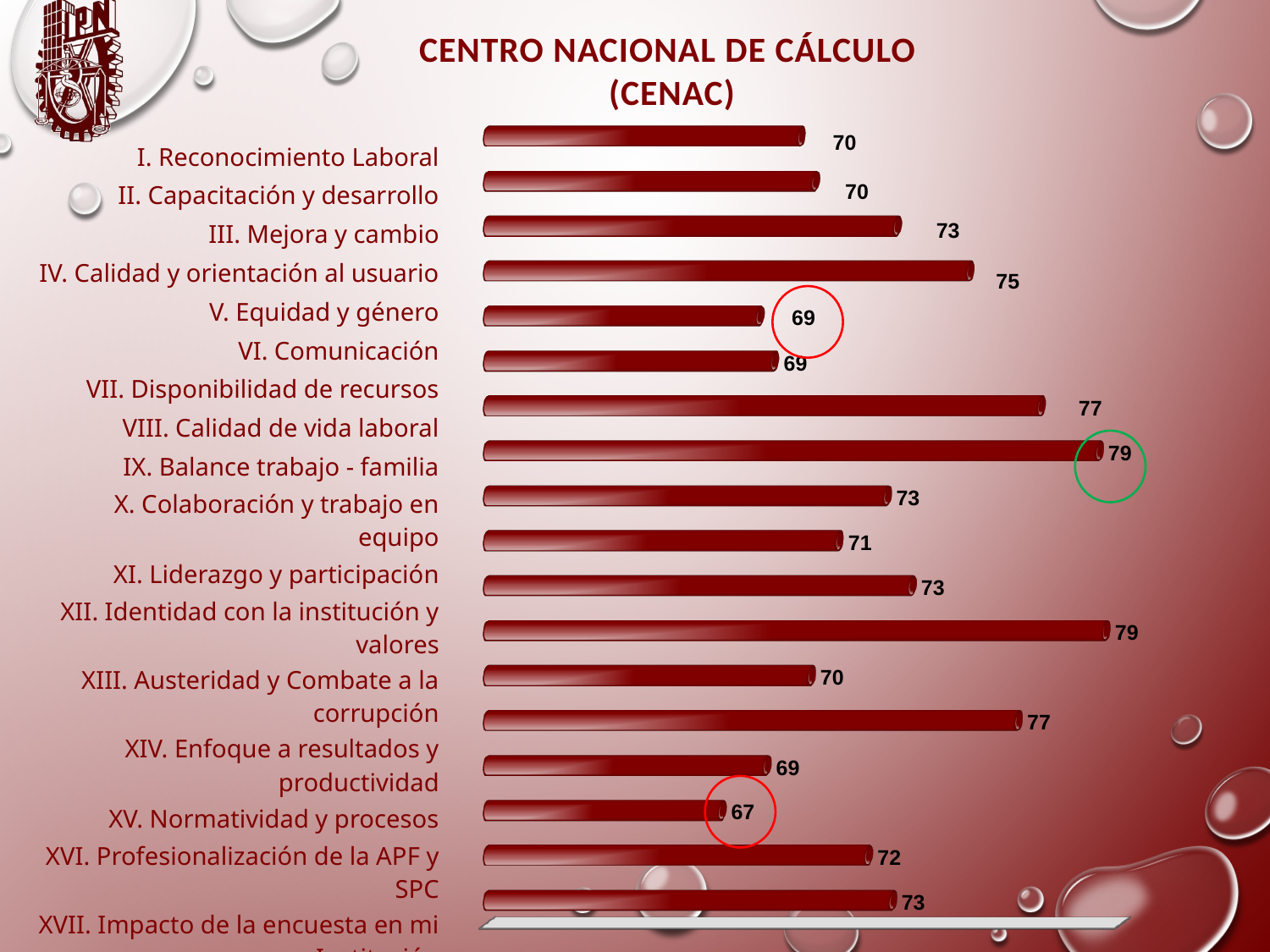
What type of chart is shown on the slide? bar chart Which value is circled in green on the chart? 79 What is the value of the fourth bar from the top? 75 Which is larger, the third bar from the top (73) or the fourth bar from the top (75)? the fourth bar (75) What is the lowest value shown in the chart? 67 What is the difference between the highest value (79) and the lowest value (67) in the chart? 12 What is the title of the chart? CENTRO NACIONAL DE CÁLCULO (CENAC) How many bars in the chart have a value of 73? 4 What is the highest value shown in the chart? 79 What is the value of the topmost bar in the chart? 70 What is the value of the bottom bar in the chart? 73 How many bars are plotted in the chart? 18